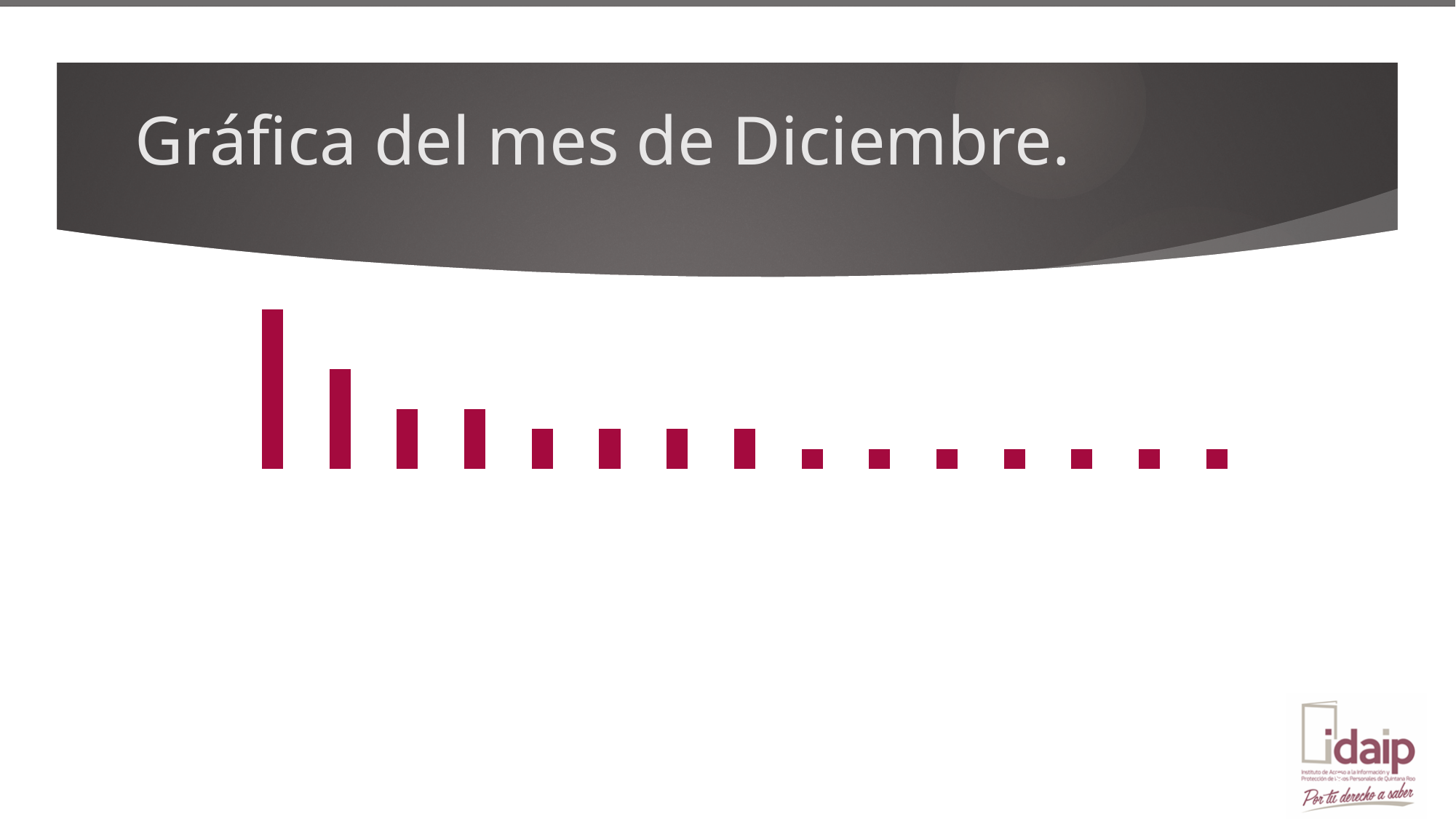
Which is taller, the first bar or the second bar from the left? the first bar How many bars does the chart contain? 15 Which is taller, the second bar or the third bar from the left? the second bar What is the title of the slide containing the chart? Gráfica del mes de Diciembre. Which is taller, the fourth bar or the fifth bar from the left? the fourth bar Do the bar values rise or fall from left to right across the chart? fall Which bar is the tallest in the chart? the leftmost (first) bar What kind of chart is shown on the slide? bar chart What colour are the bars in the chart? magenta (dark pink/crimson)